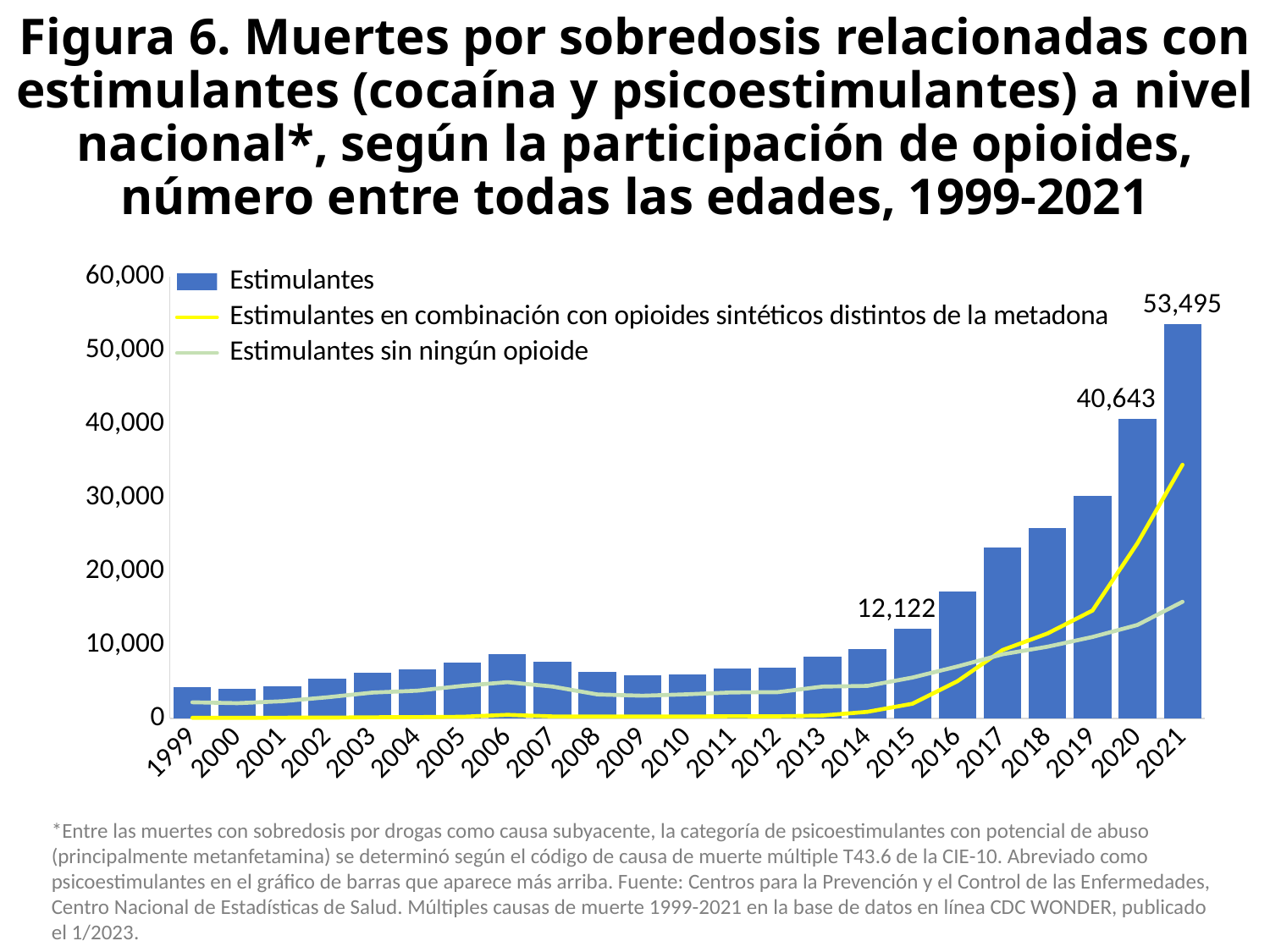
Which year has the highest Estimulantes bar? 2021 Is the Estimulantes bar for 2018 greater or less than 20,000? greater Is the Estimulantes bar for 2006 greater or less than 10,000? less What is the value of the Estimulantes bar for 2015? 12,122 What is the value of the Estimulantes bar for 2021? 53,495 What is the value of the Estimulantes bar for 2020? 40,643 Do the Estimulantes bars rise or fall from 2015 to 2021? rise How many years are shown on the x axis? 23 Which is larger, the Estimulantes bar for 2020 or for 2021? 2021 What is the difference between the Estimulantes values for 2021 and 2020? 12,852 How many series does the legend list? 3 What is the difference between the Estimulantes values for 2020 and 2015? 28,521